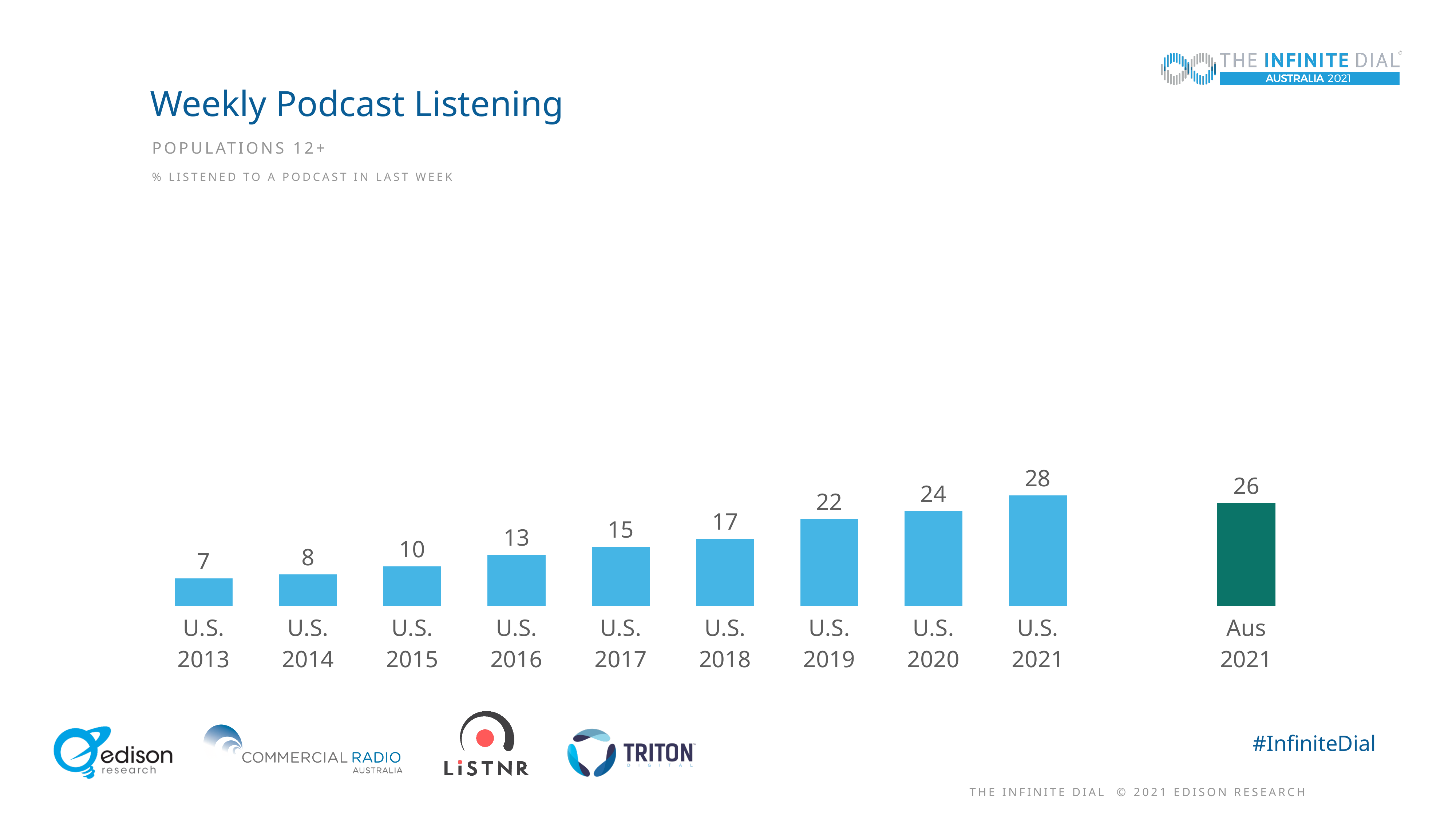
Do the U.S. values rise or fall from 2013 to 2021? Rise How many bars are shown in the chart? 10 What kind of chart is shown on the slide? Bar chart What is the value for U.S. 2013? 7 What is the value for U.S. 2018? 17 Which category has the lowest value? U.S. 2013 What is the difference between the values for U.S. 2021 and Aus 2021? 2 What is the value for Aus 2021? 26 What is the title of the chart? Weekly Podcast Listening Which is larger, the value for U.S. 2019 or the value for Aus 2021? Aus 2021 Which category has the highest value? U.S. 2021 What is the difference between the values for U.S. 2020 and U.S. 2016? 11